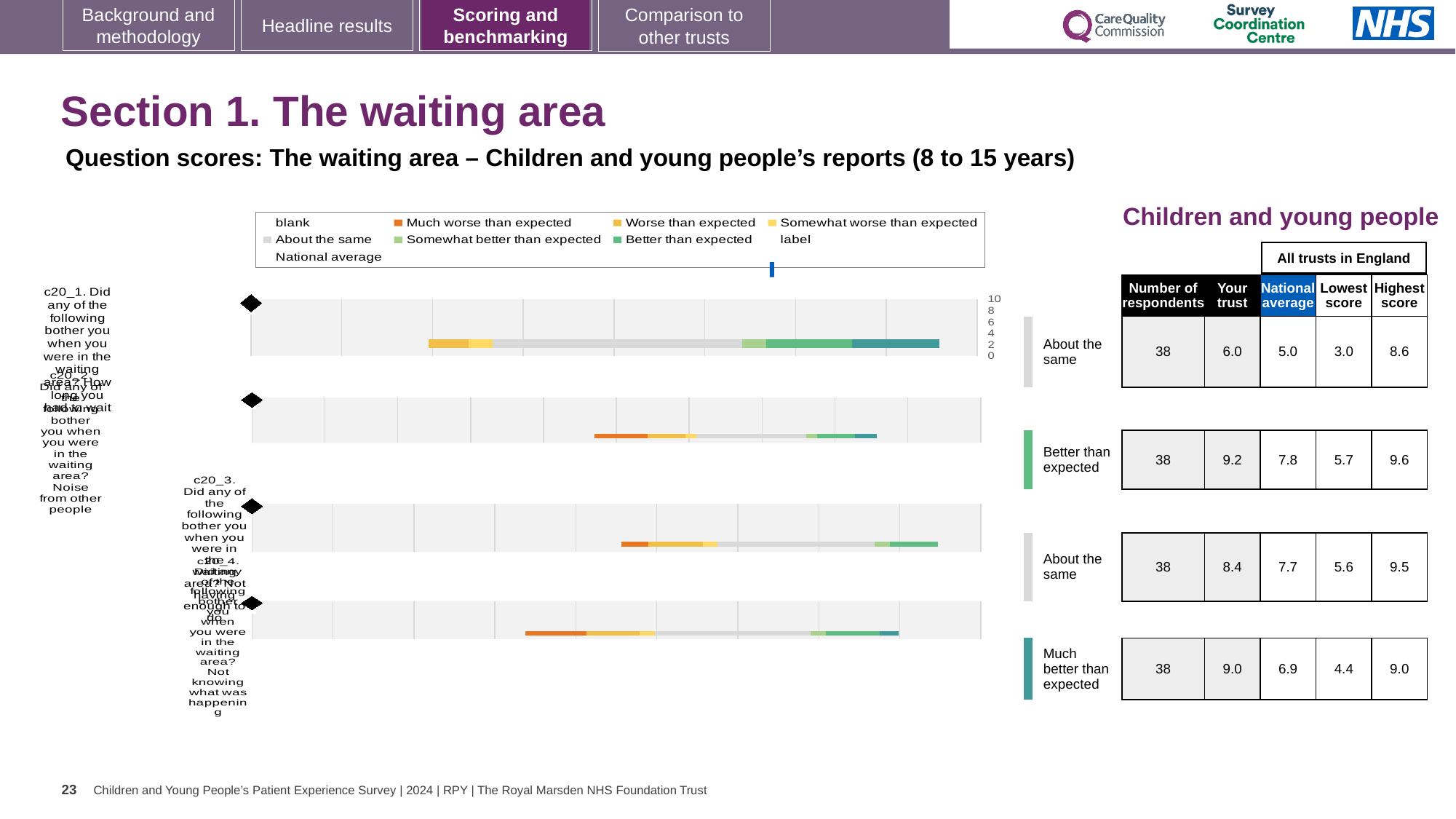
Which question row has the lowest 'Your trust' score in the table beside the chart? c20_1 (first row), 6.0 How many entries does the chart legend list? 9 How many question rows (bars) are plotted in the chart? 4 Which question row has the highest 'Your trust' score in the table beside the chart? c20_2 (second row), 9.2 What is the difference between the 'Your trust' score and the national average for the second question row (c20_2)? 1.4 In the table beside the chart, what is the 'Your trust' score for the first question row (c20_1, noise from other people)? 6.0 How many respondents are listed for each question row in the table beside the chart? 38 What kind of chart is shown on the slide? bar chart What is the highest value shown on the chart's score axis? 10 In the table beside the chart, what is the national average for the fourth question row (c20_4, not knowing what was happening)? 6.9 In the table beside the chart, what is the 'Your trust' score for the second question row (c20_2, how long you had to wait)? 9.2 For the third question row (c20_3), is the 'Your trust' score or the national average larger? Your trust (8.4)